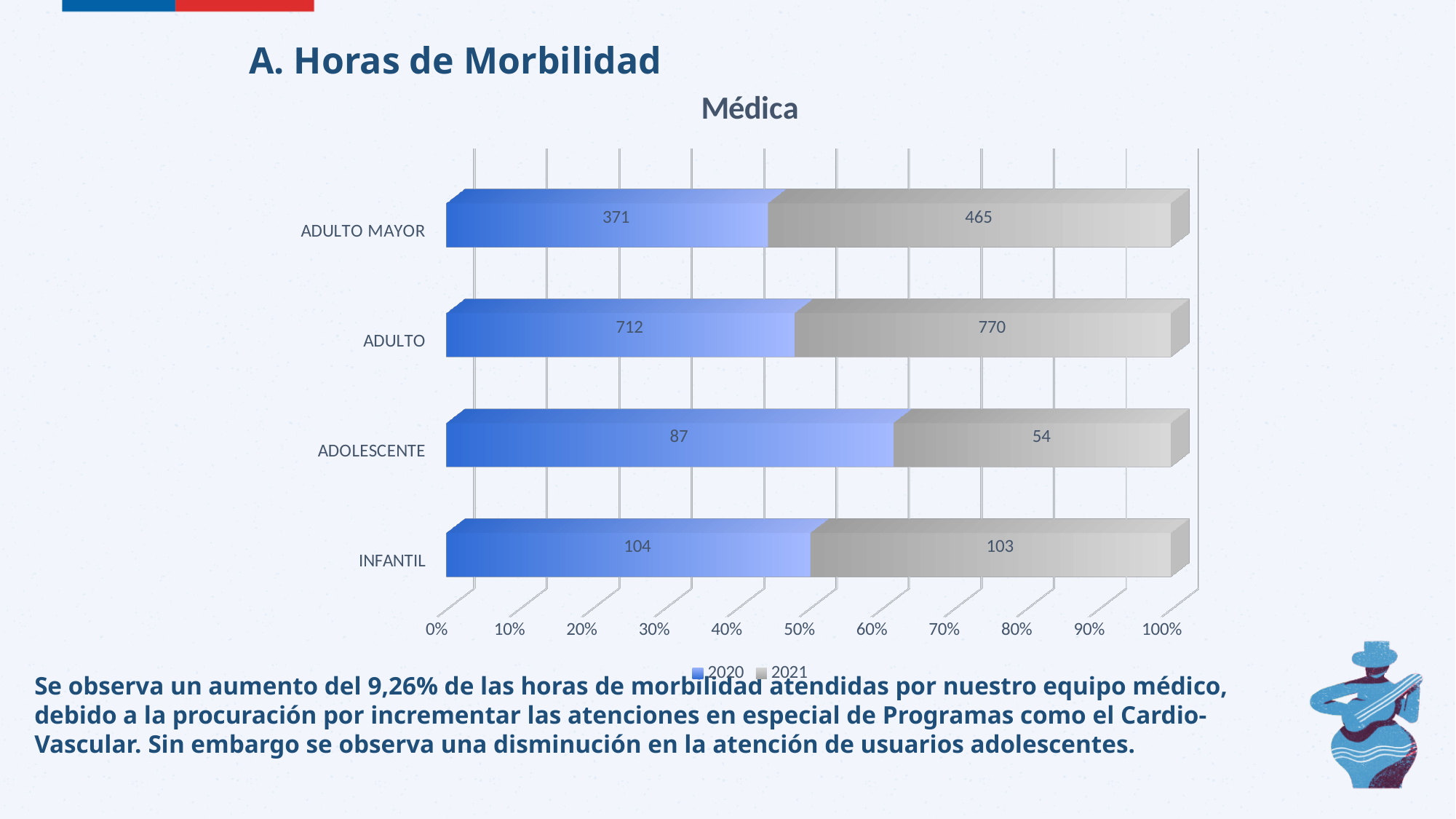
What is the difference between the 2020 and 2021 values for ADOLESCENTE? 33 What is the value for INFANTIL in the 2020 series? 104 Which category has the highest value in the 2021 series? ADULTO What is the title of the chart? Médica Which category has the lowest value in the 2020 series? ADOLESCENTE What is the difference between the 2021 and 2020 values for ADULTO MAYOR? 94 What kind of chart is shown on the slide? Stacked bar chart What is the value for ADOLESCENTE in the 2021 series? 54 Which is larger for ADULTO: the 2020 value or the 2021 value? 2021 What is the value for ADULTO MAYOR in the 2020 series? 371 How many categories are shown on the chart? 4 How many series does the legend list? 2